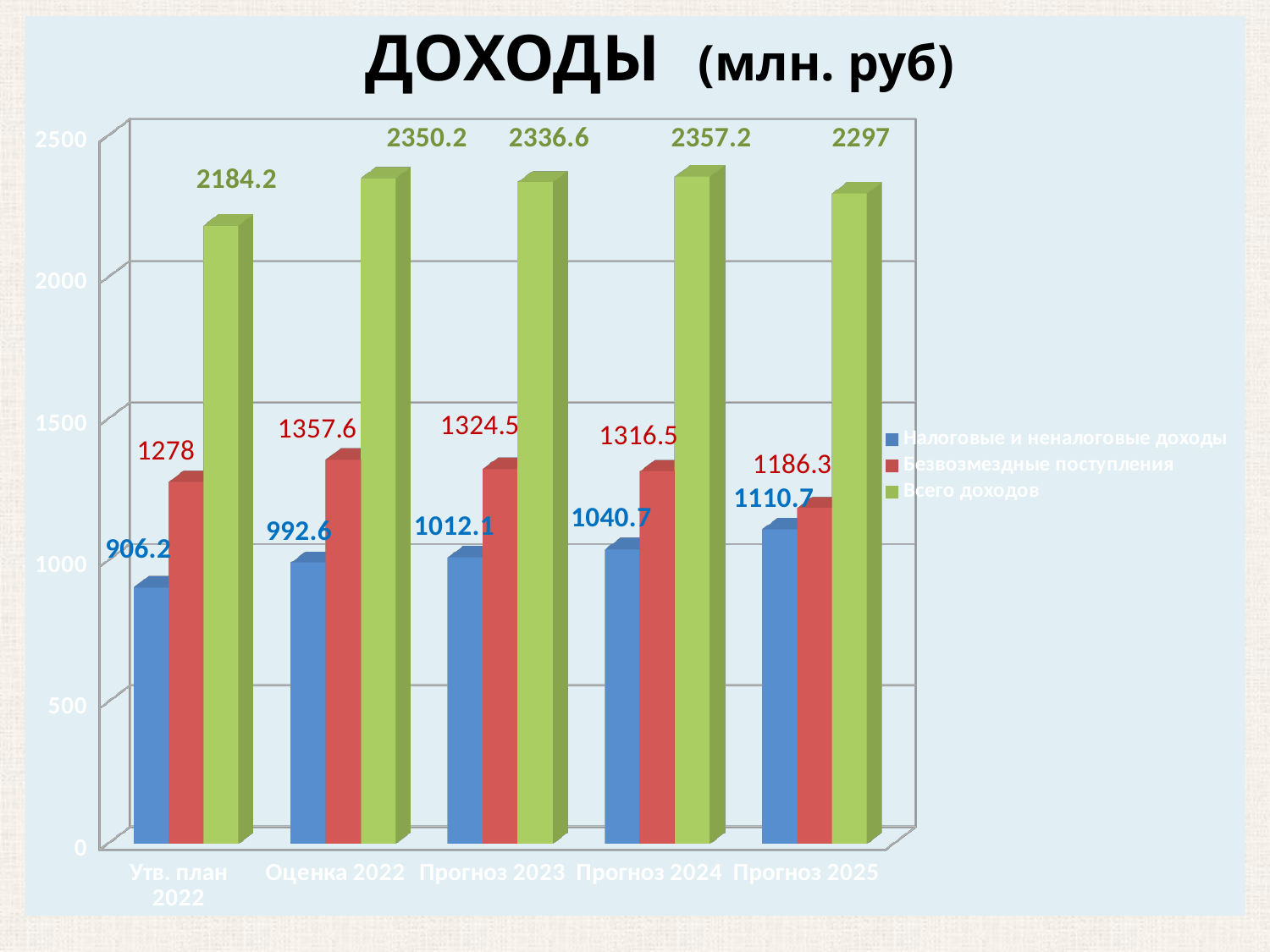
What is the value of Безвозмездные поступления for Оценка 2022? 1357.6 How many categories are shown on the x axis? 5 Do the values of Налоговые и неналоговые доходы rise or fall from Утв. план 2022 to Прогноз 2025? rise What type of chart is shown on the slide? bar chart In which category is Всего доходов the lowest? Утв. план 2022 Which is larger for Прогноз 2025: Налоговые и неналоговые доходы or Безвозмездные поступления? Безвозмездные поступления In which category is Безвозмездные поступления the highest? Оценка 2022 How many series does the legend list? 3 What colour represents Всего доходов in the chart? green What is the difference between Всего доходов for Прогноз 2024 and Прогноз 2025? 60.2 What is the value of Налоговые и неналоговые доходы for Утв. план 2022? 906.2 What is the value of Всего доходов for Прогноз 2024? 2357.2